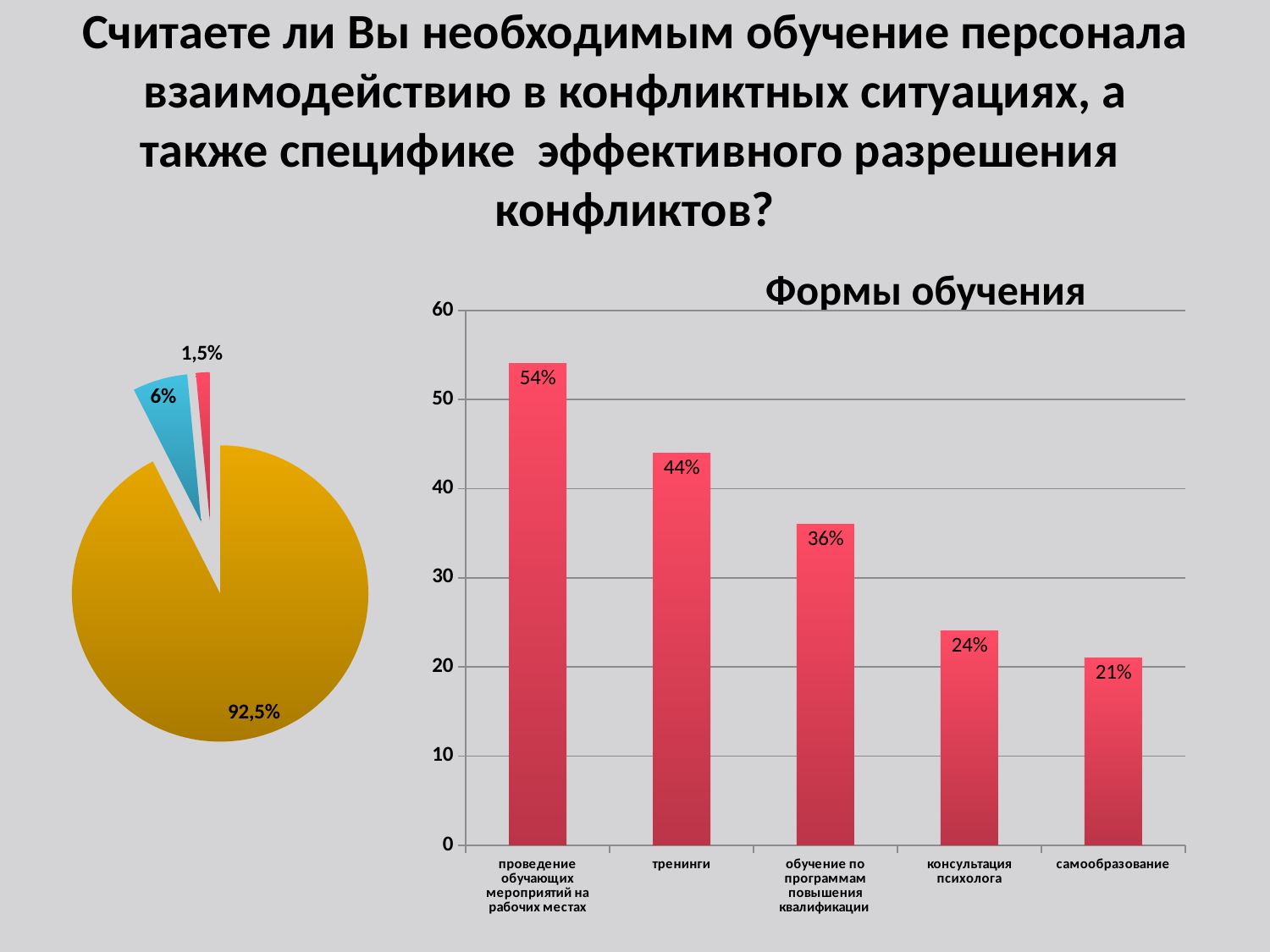
In the pie chart on the left side of the slide, how many slices are there? 3 In the bar chart titled "Формы обучения", what is the value for "самообразование"? 21% In the bar chart titled "Формы обучения", what is the difference between the values for "проведение обучающих мероприятий на рабочих местах" and "обучение по программам повышения квалификации"? 18% In the pie chart on the left side of the slide, what is the value of the largest slice? 92,5% In the bar chart titled "Формы обучения", how many categories are shown? 5 In the bar chart titled "Формы обучения", which is larger: the value for "тренинги" or the value for "консультация психолога"? тренинги In the bar chart titled "Формы обучения", which category has the highest value? проведение обучающих мероприятий на рабочих местах In the bar chart titled "Формы обучения", which category has the lowest value? самообразование What kind of chart is the chart on the left side of the slide? pie chart In the bar chart titled "Формы обучения", what is the value for "тренинги"? 44% In the bar chart titled "Формы обучения", do the values rise or fall from left to right? fall In the bar chart titled "Формы обучения", what is the value for "консультация психолога"? 24%